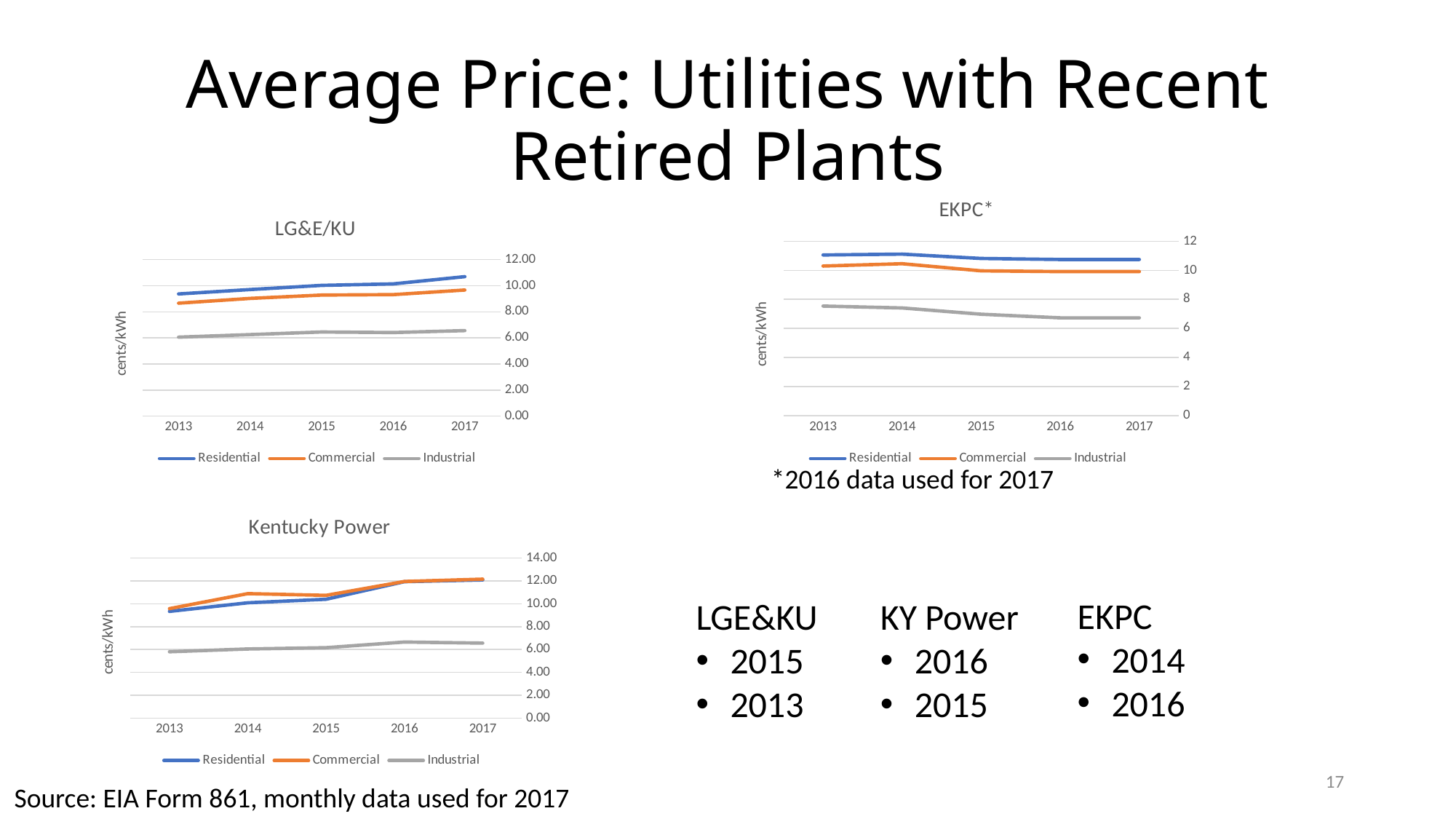
In the LG&E/KU chart, is the Residential value for 2017 greater or less than 10.00? greater How many years are shown on the x axis of the Kentucky Power chart? 5 In the EKPC* chart, is the Residential value for 2013 greater or less than 10? greater In the LG&E/KU chart, which is larger in 2017, Residential or Industrial? Residential In the Kentucky Power chart, is the Residential value for 2013 greater or less than 10.00? less In the EKPC* chart, does the Industrial line rise or fall from 2013 to 2017? fall In the EKPC* chart, which series has the lowest values across all years? Industrial In the LG&E/KU chart, does the Residential line rise or fall from 2013 to 2017? rise What kind of chart is the LG&E/KU chart? line chart What is the y-axis label on the Kentucky Power chart? cents/kWh How many series does the legend of the EKPC* chart list? 3